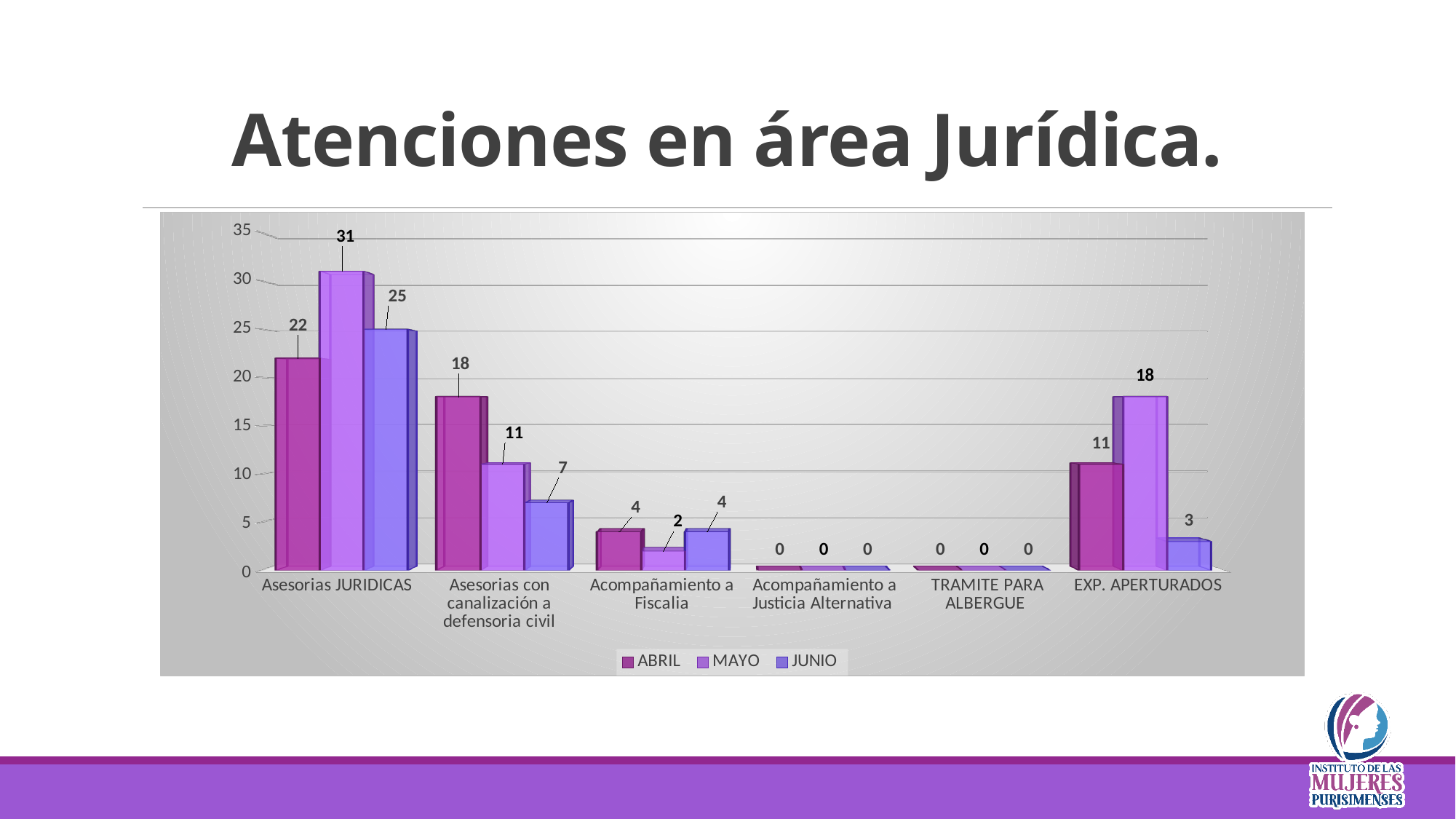
Is the JUNIO value for Asesorias JURIDICAS greater or less than 20? greater Which month has the lowest value in the Acompañamiento a Fiscalia category? MAYO How many categories are shown on the x axis? 6 Which is larger in the EXP. APERTURADOS category, the MAYO value or the JUNIO value? MAYO What is the value for MAYO in the Asesorias JURIDICAS category? 31 What is the value for JUNIO in the Asesorias con canalización a defensoria civil category? 7 Which category has the highest MAYO value? Asesorias JURIDICAS What is the title of the slide? Atenciones en área Jurídica. What kind of chart is shown on the slide? Bar chart How many series does the legend list? 3 What is the value for ABRIL in the EXP. APERTURADOS category? 11 What is the difference between the MAYO and ABRIL values for Asesorias JURIDICAS? 9